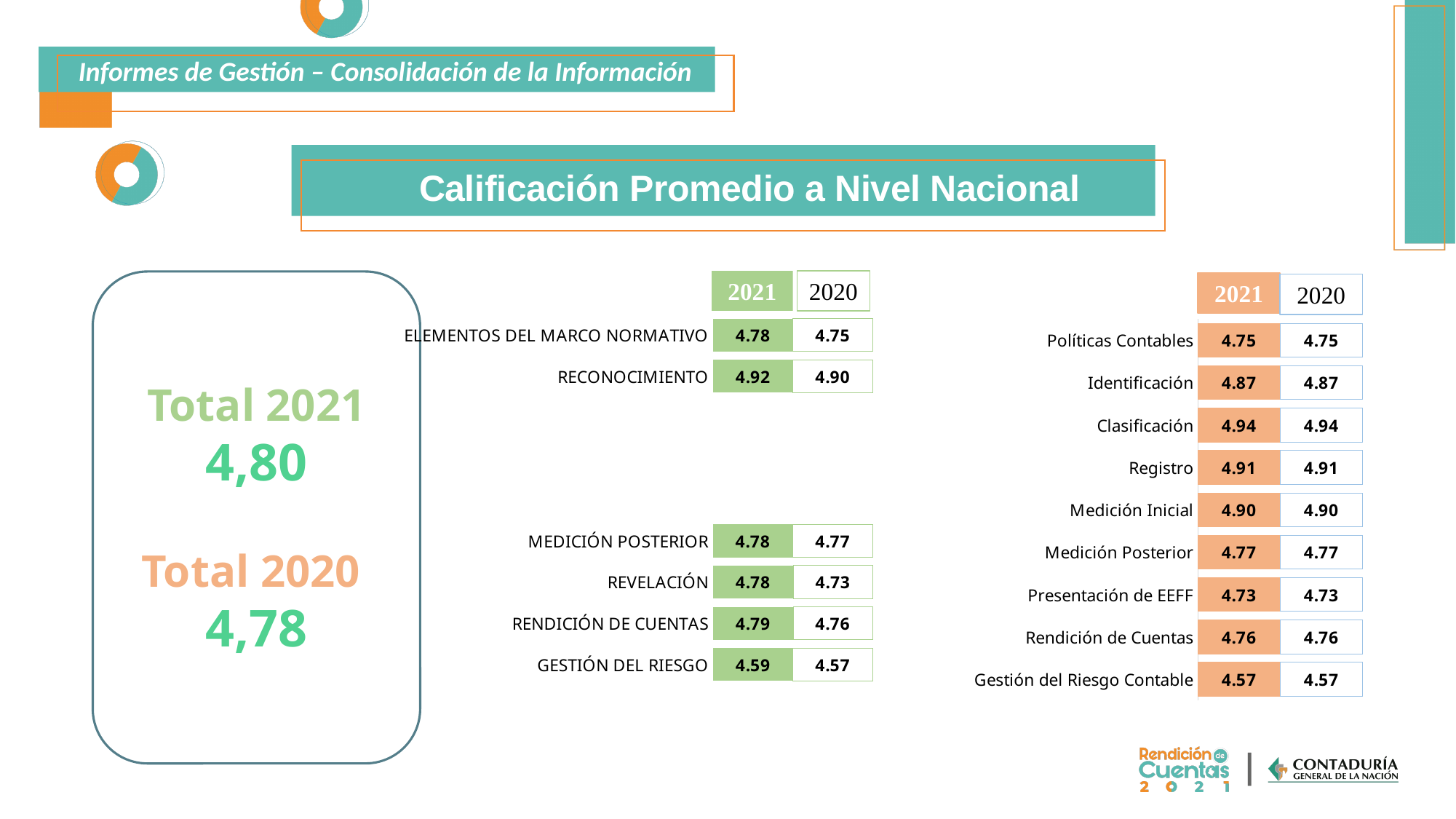
In the middle table, which category has the highest 2021 value? RECONOCIMIENTO In the right table, what is the 2020 value for Presentación de EEFF? 4.73 How many categories are listed in the right table? 9 In the right table, which category has the highest 2021 value? Clasificación What is the Total 2021 value shown in the box on the left? 4,80 In the middle table, is the 2021 value for RENDICIÓN DE CUENTAS higher or lower than its 2020 value? higher In the right table, what is the 2021 value for Clasificación? 4.94 How many year columns does the middle table have? 2 In the middle table, what is the 2020 value for GESTIÓN DEL RIESGO? 4.57 In the middle table, which category has the lowest 2021 value? GESTIÓN DEL RIESGO In the middle table, what is the difference between the 2021 and 2020 values for REVELACIÓN? 0.05 In the middle table, what is the 2021 value for RECONOCIMIENTO? 4.92